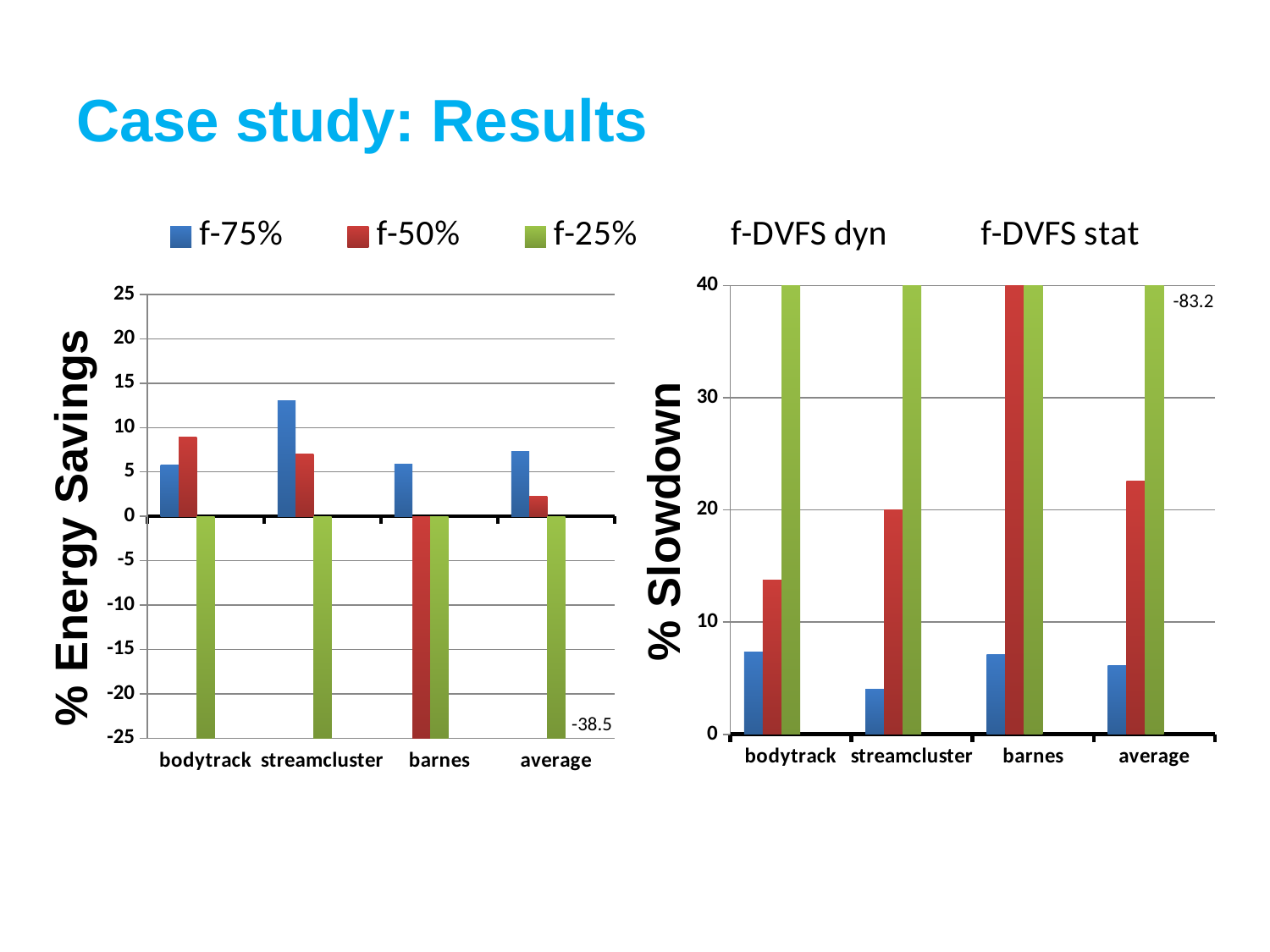
In the left chart (% Energy Savings), which category has the highest f-75% value? streamcluster In the right chart (% Slowdown), which category has the lowest f-75% value? streamcluster In the right chart (% Slowdown), which category has the highest f-50% value? barnes In the left chart (% Energy Savings), which is larger for bodytrack: the f-75% value or the f-50% value? f-50% In the right chart (% Slowdown), is the f-75% value for bodytrack greater or less than 10? less In the left chart (% Energy Savings), is the f-50% value for barnes greater or less than 0? less In the left chart (% Energy Savings), is the f-75% value for streamcluster greater or less than 10? greater What is the y-axis title of the right chart? % Slowdown In the left chart (% Energy Savings), what value is printed next to the f-25% bar for average? -38.5 How many categories are shown on the x axis of the right chart (% Slowdown)? 4 What kind of chart is the left chart (% Energy Savings)? bar chart